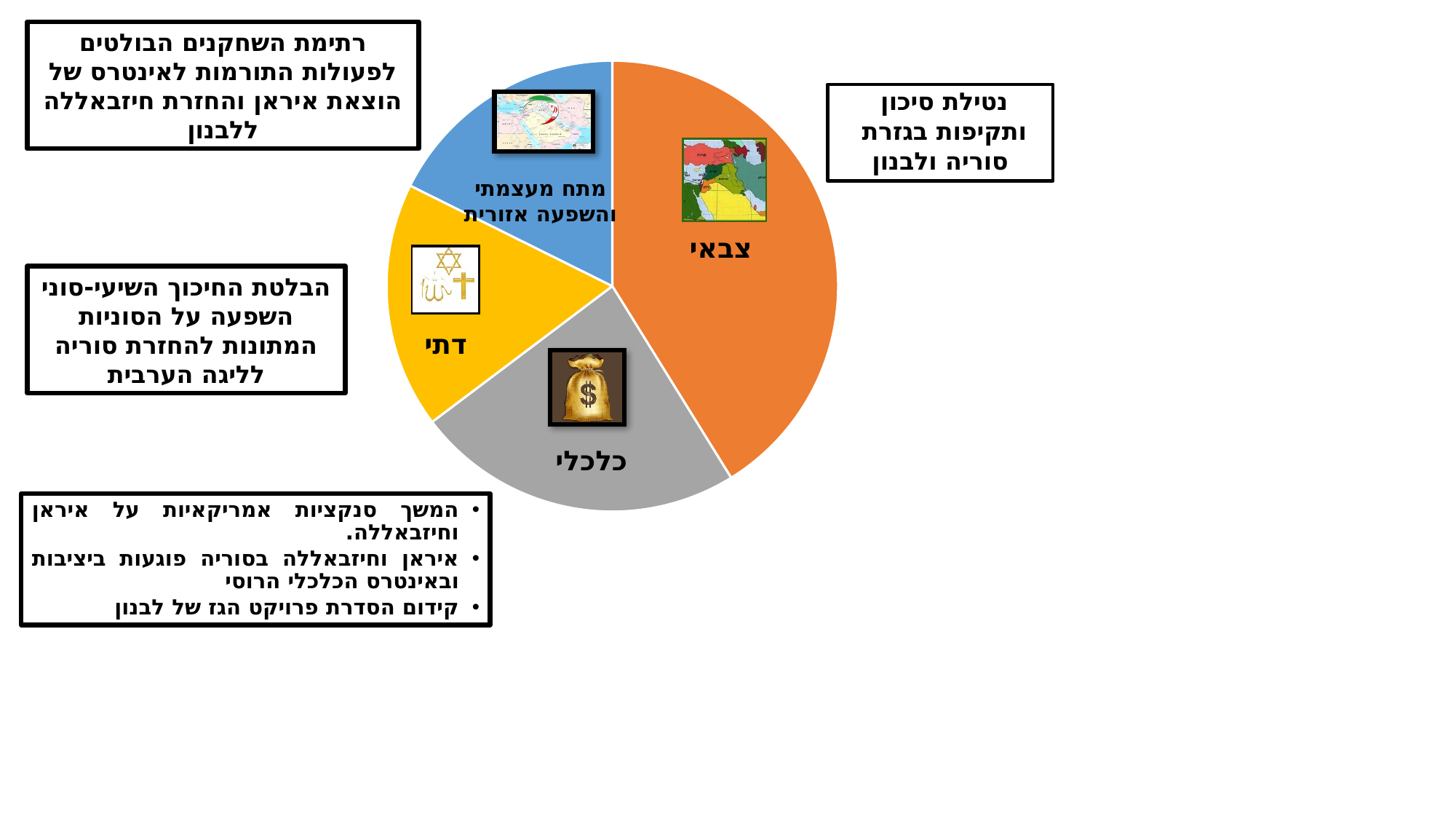
Which slice of the pie chart is coloured yellow? דתי How many slices does the pie chart have? 4 Which slice is larger, כלכלי or דתי? כלכלי Which slice is larger, צבאי or כלכלי? צבאי Which slice is larger, צבאי or דתי? צבאי What kind of chart is shown on the slide? pie chart Which slice of the pie chart is the largest? צבאי What colour is the צבאי slice of the pie chart? orange